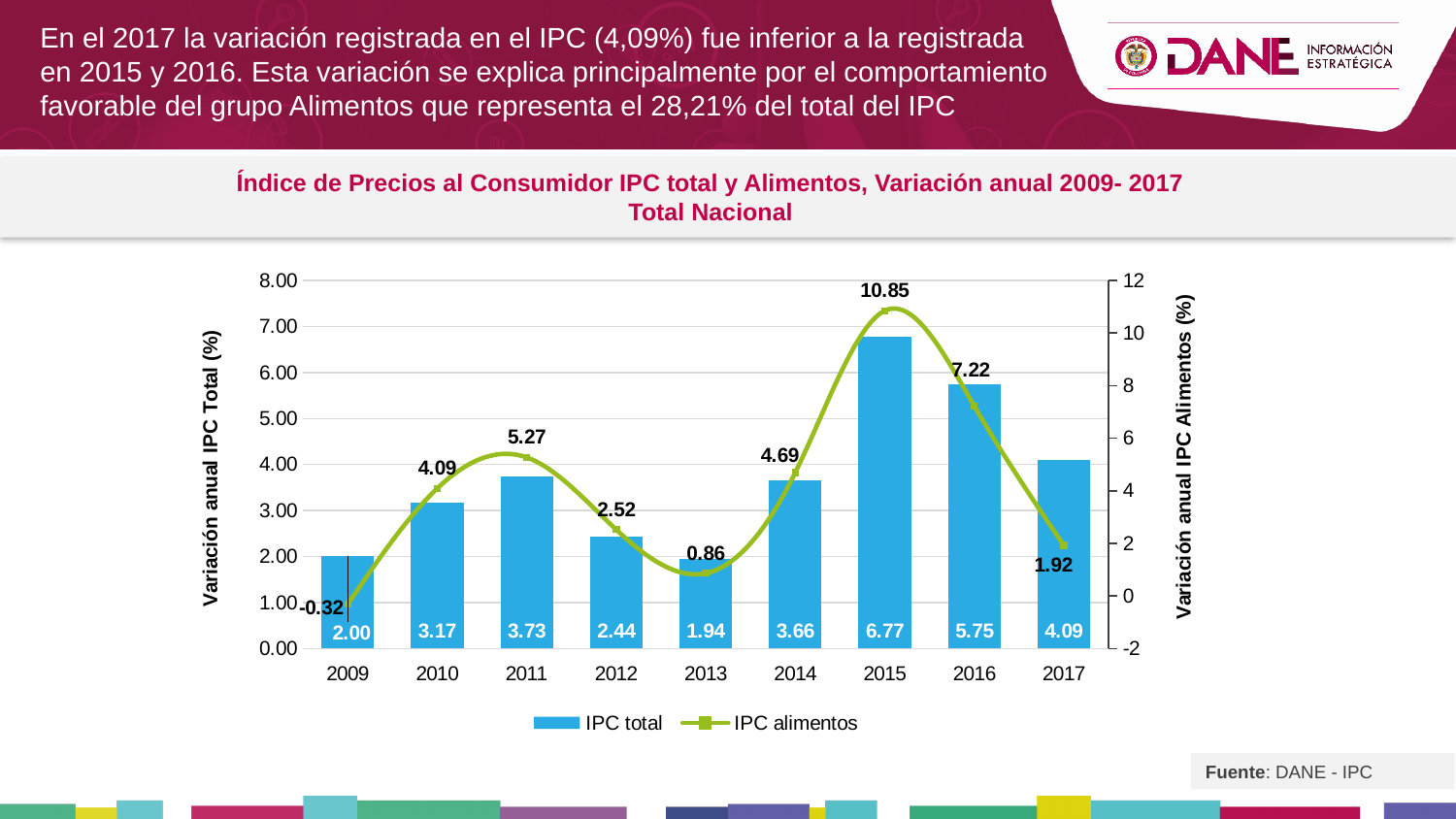
What is the IPC total value for 2017? 4.09 What is the title of the chart? Índice de Precios al Consumidor IPC total y Alimentos, Variación anual 2009- 2017 Total Nacional Which year has the highest IPC alimentos value? 2015 Does the IPC total value rise or fall from 2015 to 2017? fall Which year has the lowest IPC total value? 2013 What is the IPC total value for 2015? 6.77 What is the IPC alimentos value for 2011? 5.27 What is the difference between the IPC total values for 2015 and 2016? 1.02 Which is larger, the IPC alimentos value for 2014 or for 2012? 2014 What is the IPC alimentos value for 2009? -0.32 How many years are shown on the x axis? 9 How many series does the legend list? 2